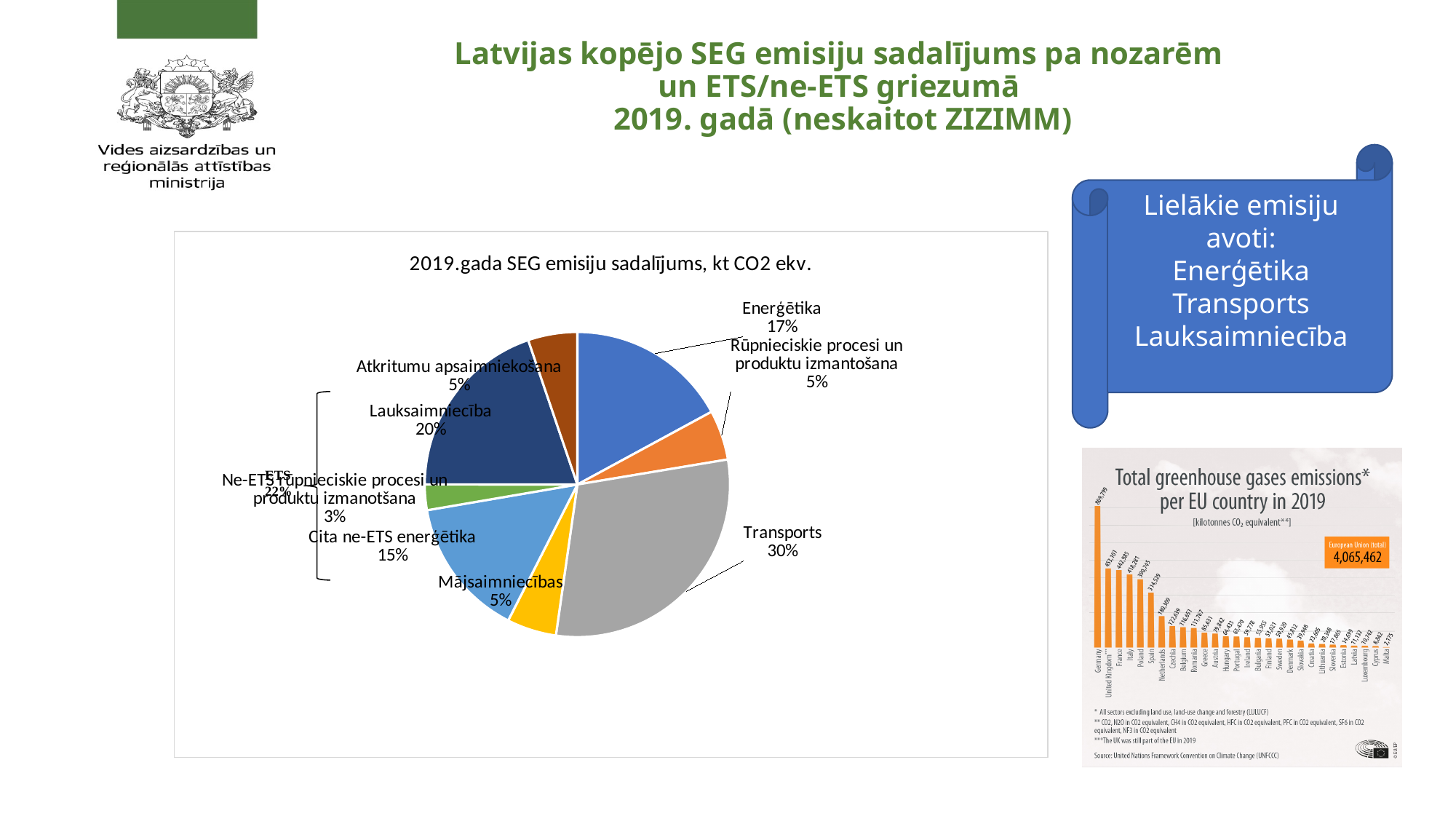
In the pie chart titled "2019.gada SEG emisiju sadalījums, kt CO2 ekv.", what share does Ne-ETS rūpnieciskie procesi un produktu izmantošana have? 3% In the pie chart titled "2019.gada SEG emisiju sadalījums, kt CO2 ekv.", what share does Cita ne-ETS enerģētika have? 15% How many slices does the pie chart titled "2019.gada SEG emisiju sadalījums, kt CO2 ekv." have? 8 What kind of chart is the chart titled "2019.gada SEG emisiju sadalījums, kt CO2 ekv."? Pie chart In the pie chart titled "2019.gada SEG emisiju sadalījums, kt CO2 ekv.", which sector has the largest share? Transports In the pie chart titled "2019.gada SEG emisiju sadalījums, kt CO2 ekv.", what share does Lauksaimniecība have? 20% In the pie chart titled "2019.gada SEG emisiju sadalījums, kt CO2 ekv.", which is larger: Enerģētika or Cita ne-ETS enerģētika? Enerģētika In the pie chart titled "2019.gada SEG emisiju sadalījums, kt CO2 ekv.", which sector has the smallest share? Ne-ETS rūpnieciskie procesi un produktu izmantošana In the pie chart titled "2019.gada SEG emisiju sadalījums, kt CO2 ekv.", what is the difference in percentage points between Transports and Lauksaimniecība? 10 percentage points In the chart titled "Total greenhouse gases emissions per EU country in 2019" on the right of the slide, which country has the highest emissions? Germany In the pie chart titled "2019.gada SEG emisiju sadalījums, kt CO2 ekv.", what share does Transports have? 30% In the pie chart titled "2019.gada SEG emisiju sadalījums, kt CO2 ekv.", what share does Enerģētika have? 17%